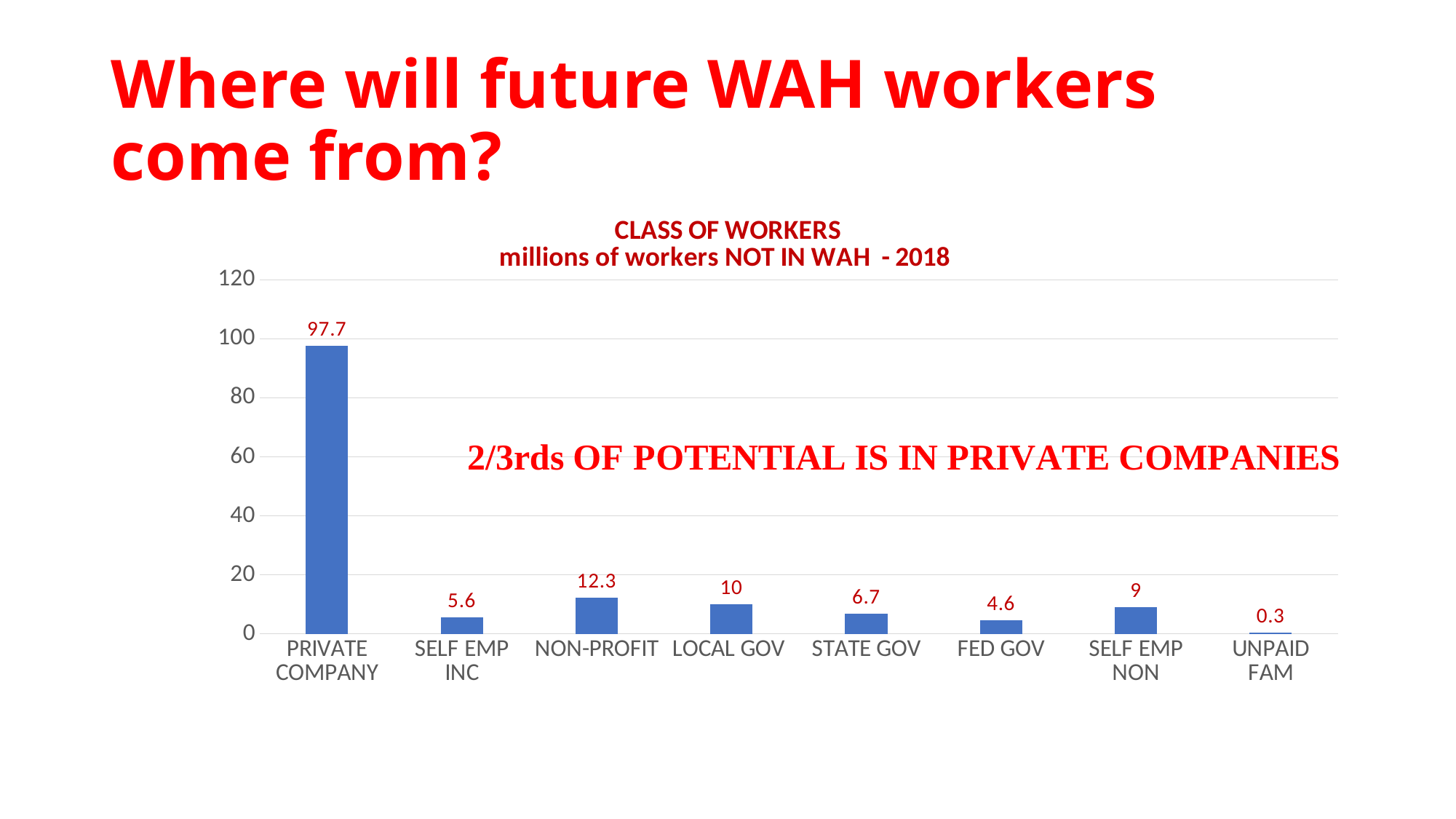
What is the value for FED GOV? 4.6 What is the difference between the values for LOCAL GOV and STATE GOV? 3.3 What is the title of the chart? CLASS OF WORKERS millions of workers NOT IN WAH - 2018 Is the value for PRIVATE COMPANY greater or less than 80? greater What is the value for PRIVATE COMPANY? 97.7 Which category has the lowest value? UNPAID FAM What is the value for UNPAID FAM? 0.3 Which category has the highest value? PRIVATE COMPANY What kind of chart is this? bar chart Which is larger, the value for SELF EMP INC or the value for SELF EMP NON? SELF EMP NON How many categories are shown on the x axis? 8 What is the value for NON-PROFIT? 12.3